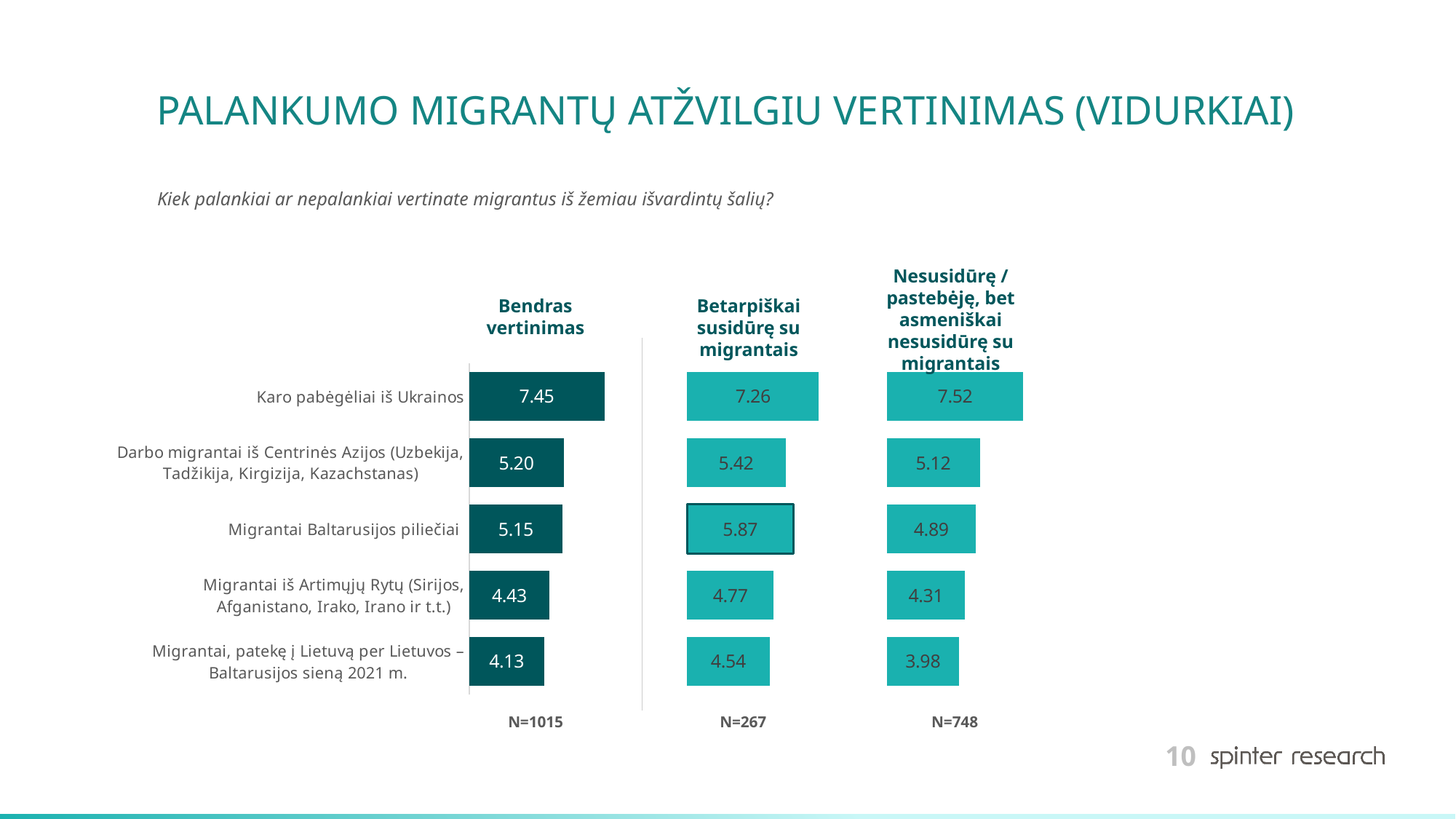
In the "Betarpiškai susidūrę su migrantais" chart, what is the value for "Migrantai Baltarusijos piliečiai"? 5.87 In the "Nesusidūrę / pastebėję, bet asmeniškai nesusidūrę su migrantais" chart, which category has the highest value? Karo pabėgėliai iš Ukrainos What kind of chart is the "Bendras vertinimas" chart? Bar chart How many categories are shown in the "Bendras vertinimas" chart? 5 In the "Nesusidūrę / pastebėję, bet asmeniškai nesusidūrę su migrantais" chart, what is the value for "Migrantai iš Artimųjų Rytų (Sirijos, Afganistano, Irako, Irano ir t.t.)"? 4.31 In the "Bendras vertinimas" chart, which category has the lowest value? Migrantai, patekę į Lietuvą per Lietuvos – Baltarusijos sieną 2021 m. What is the sample size (N) shown under the "Betarpiškai susidūrę su migrantais" chart? N=267 In the "Betarpiškai susidūrę su migrantais" chart, what is the difference between the values for "Migrantai Baltarusijos piliečiai" and "Darbo migrantai iš Centrinės Azijos (Uzbekija, Tadžikija, Kirgizija, Kazachstanas)"? 0.45 For "Karo pabėgėliai iš Ukrainos", which chart shows the larger value: "Betarpiškai susidūrę su migrantais" or "Nesusidūrę / pastebėję, bet asmeniškai nesusidūrę su migrantais"? Nesusidūrę / pastebėję, bet asmeniškai nesusidūrę su migrantais In the "Nesusidūrę / pastebėję, bet asmeniškai nesusidūrę su migrantais" chart, what is the value for "Migrantai, patekę į Lietuvą per Lietuvos – Baltarusijos sieną 2021 m."? 3.98 In the "Bendras vertinimas" chart, what is the value for "Karo pabėgėliai iš Ukrainos"? 7.45 In the "Bendras vertinimas" chart, what is the difference between the values for "Karo pabėgėliai iš Ukrainos" and "Migrantai, patekę į Lietuvą per Lietuvos – Baltarusijos sieną 2021 m."? 3.32